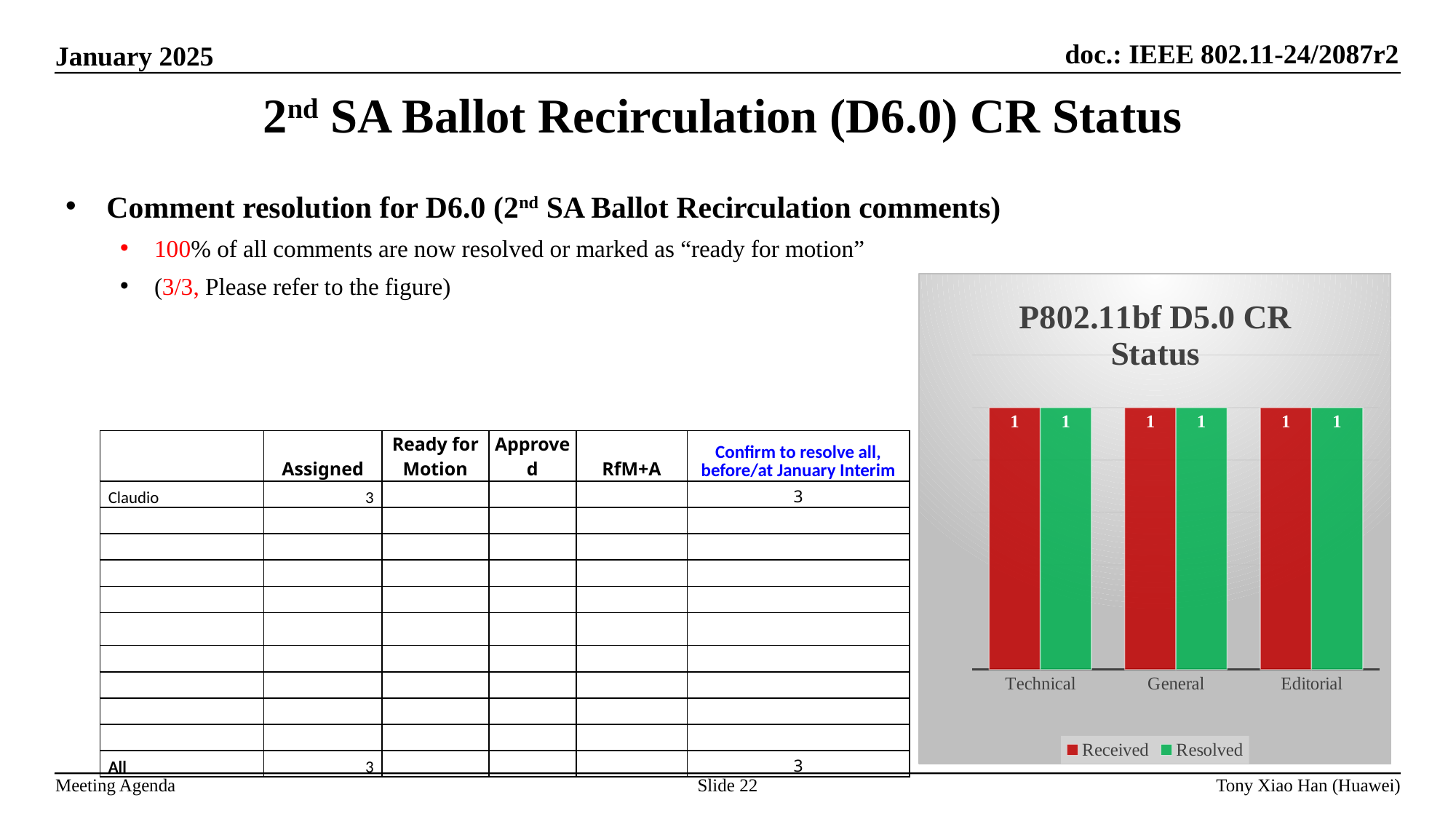
What is the Resolved value for Editorial in the chart? 1 What kind of chart is shown on the slide? Bar chart Do the Received values rise, fall, or stay the same from Technical to Editorial? Stay the same What is the title of the chart? P802.11bf D5.0 CR Status How many series does the chart legend list? 2 What is the difference between the Received value for General and the Received value for Editorial? 0 What is the Received value for Technical in the chart? 1 Which series is shown in green in the chart? Resolved How many categories are shown on the x axis of the chart? 3 What is the Resolved value for General in the chart? 1 What is the difference between the Received and Resolved values for Technical? 0 What is the Received value for Editorial in the chart? 1